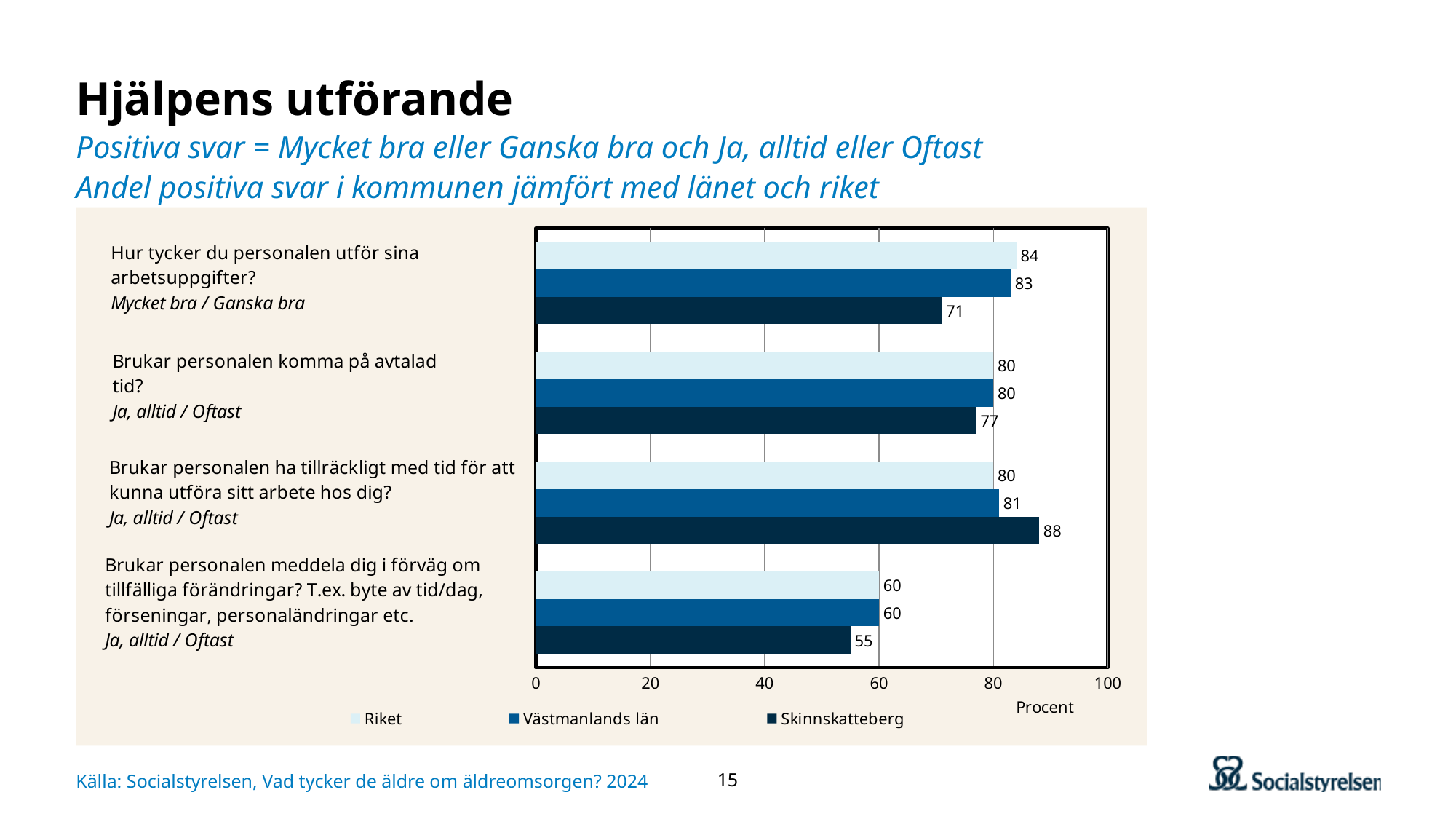
What is the value for Västmanlands län on the question "Brukar personalen ha tillräckligt med tid för att kunna utföra sitt arbete hos dig?"? 81 Is the value for Skinnskatteberg on "Brukar personalen meddela dig i förväg om tillfälliga förändringar?" greater or less than 60? less What kind of chart is shown on the slide? Bar chart Which question has the lowest value for Riket? Brukar personalen meddela dig i förväg om tillfälliga förändringar? How many series does the legend list? 3 What is the difference between Riket and Skinnskatteberg on the question "Hur tycker du personalen utför sina arbetsuppgifter?"? 13 On the question "Brukar personalen ha tillräckligt med tid för att kunna utföra sitt arbete hos dig?", which is larger: Skinnskatteberg or Riket? Skinnskatteberg What is the value for Skinnskatteberg on the question "Brukar personalen meddela dig i förväg om tillfälliga förändringar?"? 55 What unit is shown on the horizontal axis of the chart? Procent What is the value for Skinnskatteberg on the question "Hur tycker du personalen utför sina arbetsuppgifter?"? 71 Which question has the highest value for Skinnskatteberg? Brukar personalen ha tillräckligt med tid för att kunna utföra sitt arbete hos dig? What is the value for Riket on the question "Brukar personalen komma på avtalad tid?"? 80